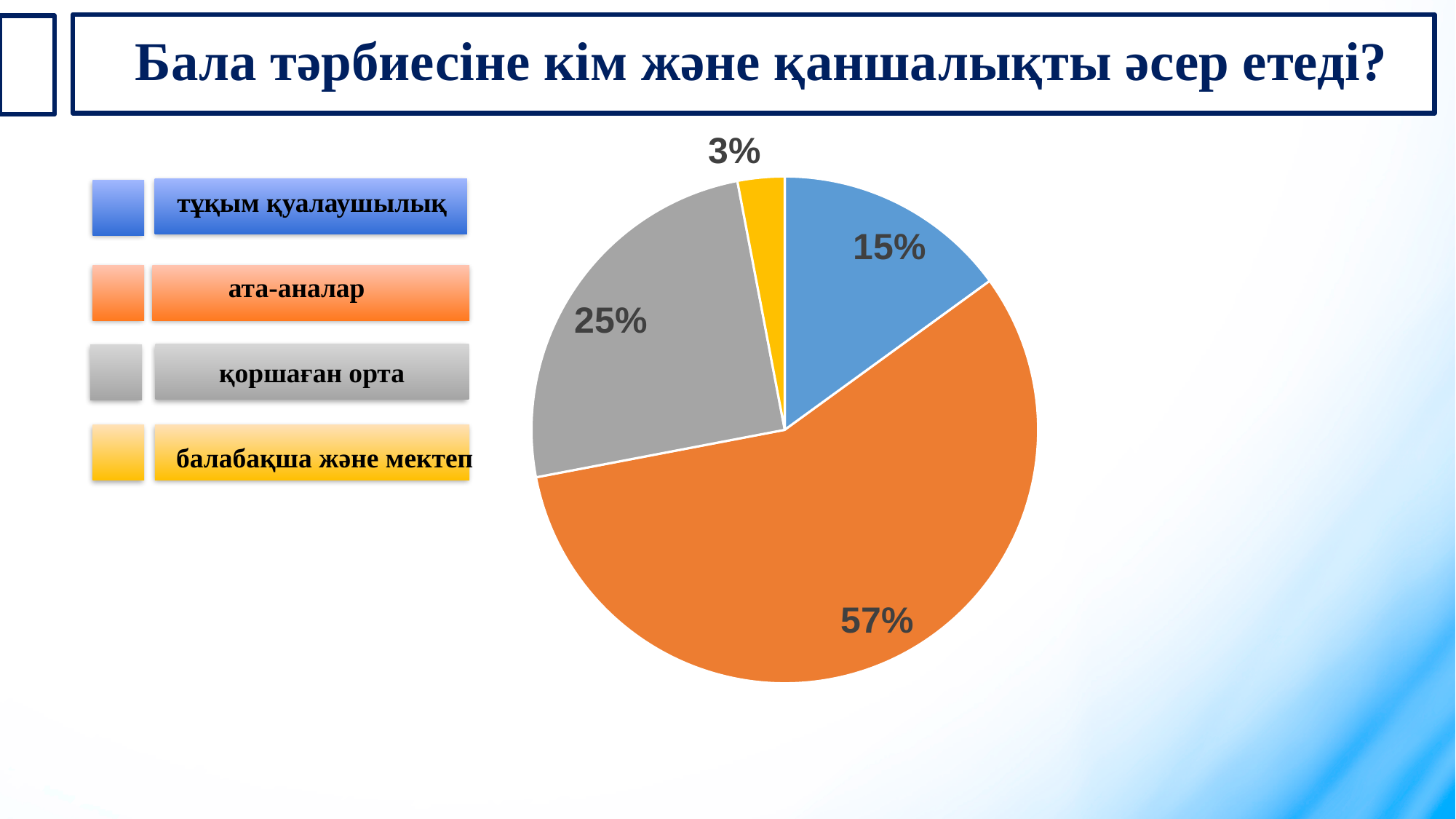
What share of the pie does "ата-аналар" (orange) have? 57% What is the difference in percentage points between "тұқым қуалаушылық" and "балабақша және мектеп"? 12 Which is larger: the share for "қоршаған орта" or the share for "тұқым қуалаушылық"? қоршаған орта What colour is the slice for "қоршаған орта"? gray What share of the pie does "тұқым қуалаушылық" (blue) have? 15% What share of the pie does "балабақша және мектеп" (yellow) have? 3% Which category has the smallest slice of the pie? балабақша және мектеп Which category has the largest slice of the pie? ата-аналар What is the difference in percentage points between "ата-аналар" and "қоршаған орта"? 32 How many slices does the pie chart have? 4 What kind of chart is shown on the slide? pie chart